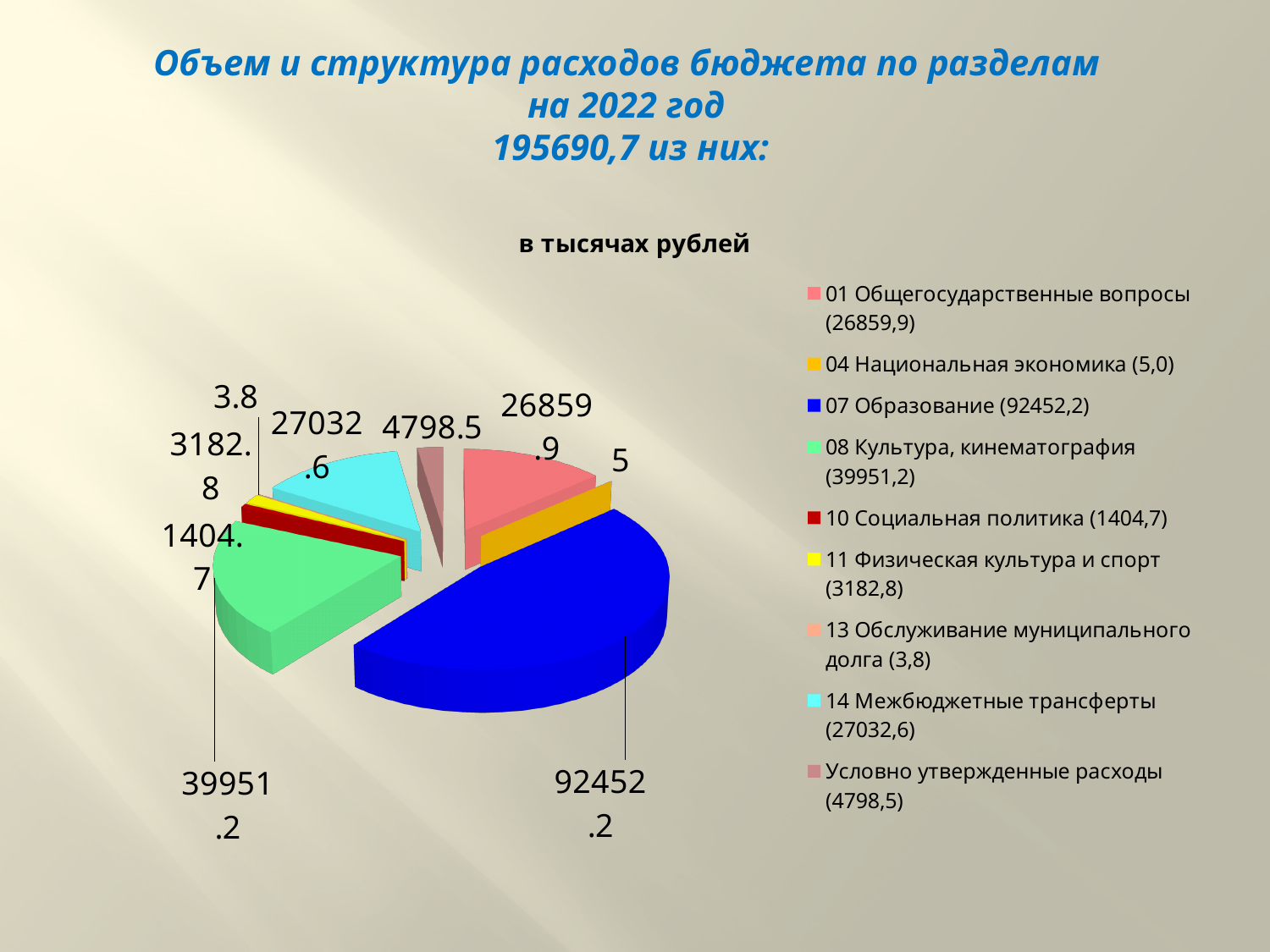
How many entries does the legend list? 9 Which category has the largest slice of the pie? 07 Образование Which is larger: 08 Культура, кинематография or 14 Межбюджетные трансферты? 08 Культура, кинематография How many slices does the pie chart have? 9 What is the value for 14 Межбюджетные трансферты? 27032.6 What is the value for 13 Обслуживание муниципального долга? 3.8 Which category has the smallest value? 13 Обслуживание муниципального долга What colour is the slice for 07 Образование? blue What is the value for 07 Образование? 92452.2 What unit is stated in the chart's subtitle? в тысячах рублей What kind of chart is shown on the slide? pie chart What is the difference between the values for 08 Культура, кинематография and 14 Межбюджетные трансферты? 12918.6